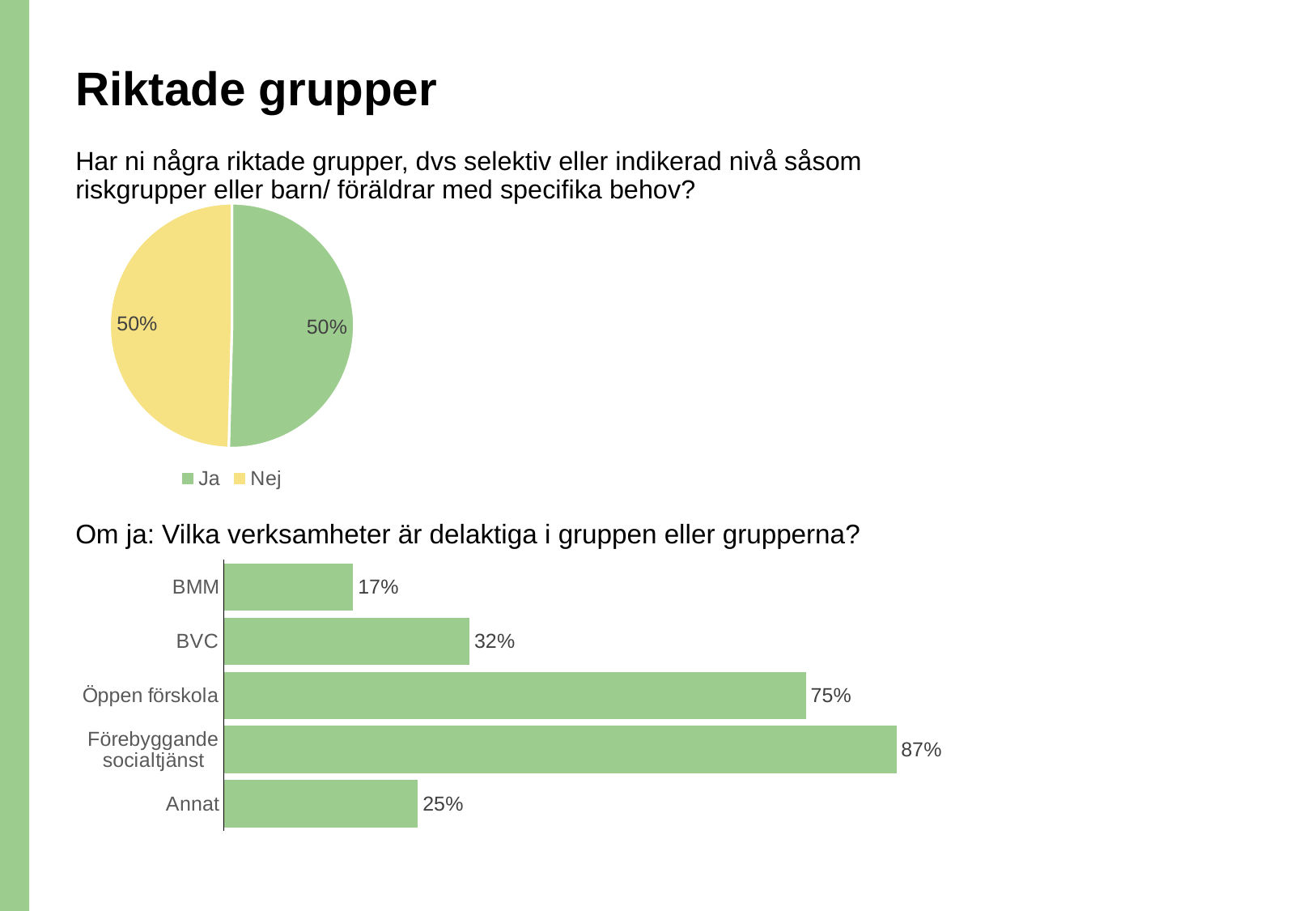
In the bar chart at the bottom of the slide, what is the difference between Öppen förskola and BVC? 43% In the bar chart at the bottom of the slide, what is the value for Förebyggande socialtjänst? 87% In the pie chart at the top of the slide, what share is labelled for Nej? 50% How many categories does the bar chart at the bottom of the slide show? 5 In the pie chart at the top of the slide, what share is labelled for Ja? 50% What kind of chart is the chart at the bottom of the slide? bar chart How many entries does the legend of the pie chart at the top of the slide list? 2 In the bar chart at the bottom of the slide, which is larger, Annat or BMM? Annat In the bar chart at the bottom of the slide, which category has the lowest value? BMM In the bar chart at the bottom of the slide, what is the value for BVC? 32% What kind of chart is the chart at the top of the slide? pie chart In the bar chart at the bottom of the slide, which category has the highest value? Förebyggande socialtjänst